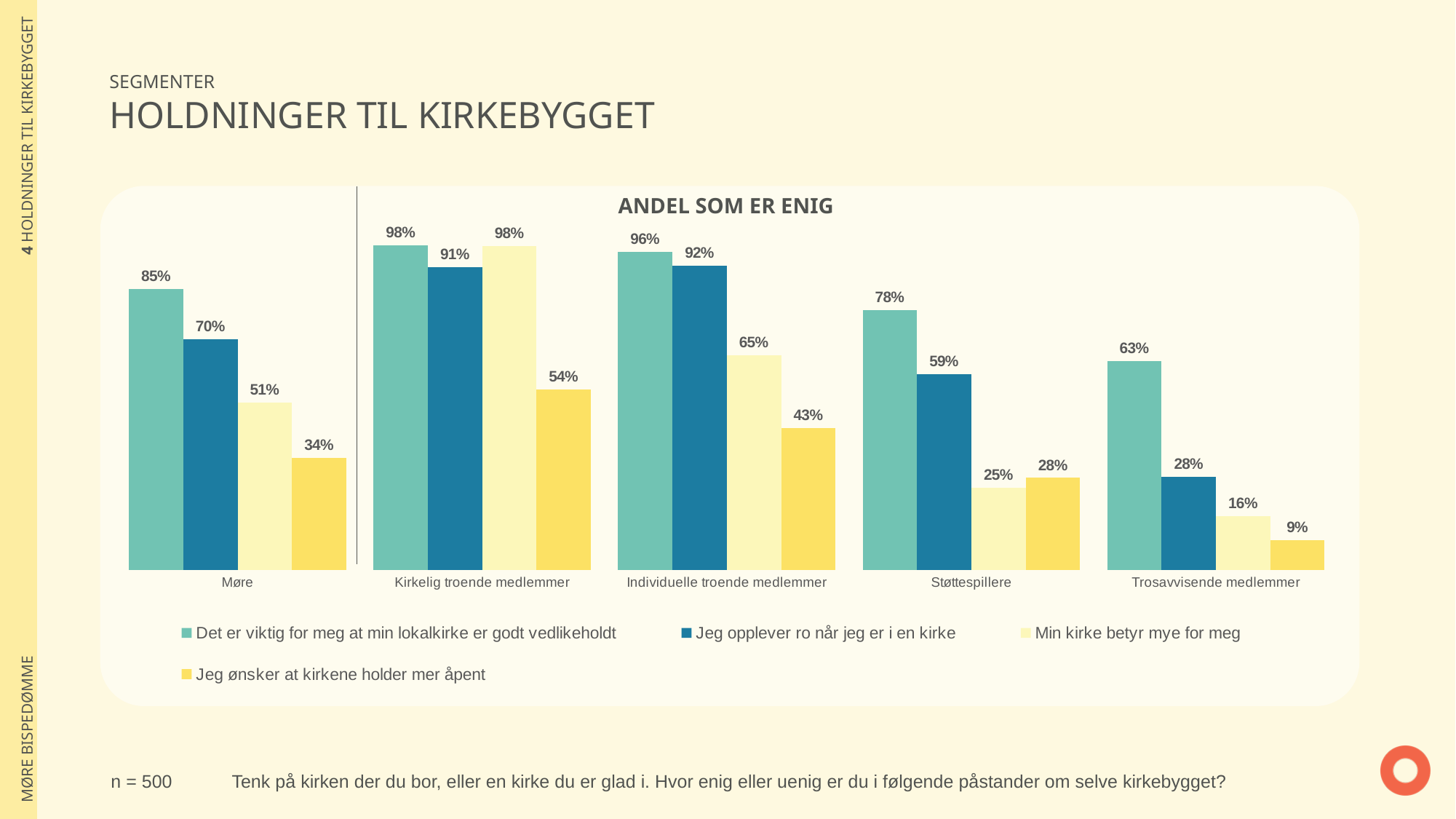
Which category has the lowest value for "Det er viktig for meg at min lokalkirke er godt vedlikeholdt"? Trosavvisende medlemmer In the Støttespillere category, which is larger: "Min kirke betyr mye for meg" or "Jeg ønsker at kirkene holder mer åpent"? Jeg ønsker at kirkene holder mer åpent What is the value for "Jeg opplever ro når jeg er i en kirke" in the Støttespillere category? 59% What is the value for "Det er viktig for meg at min lokalkirke er godt vedlikeholdt" in the Møre category? 85% What is the value for "Min kirke betyr mye for meg" in the Individuelle troende medlemmer category? 65% How many series does the legend list? 4 What is the title of the chart? ANDEL SOM ER ENIG Which category has the highest value for "Jeg ønsker at kirkene holder mer åpent"? Kirkelig troende medlemmer What is the difference between "Min kirke betyr mye for meg" and "Jeg ønsker at kirkene holder mer åpent" in the Møre category? 17% How many categories are shown on the x axis? 5 What kind of chart is shown on the slide? Bar chart What is the value for "Jeg ønsker at kirkene holder mer åpent" in the Trosavvisende medlemmer category? 9%